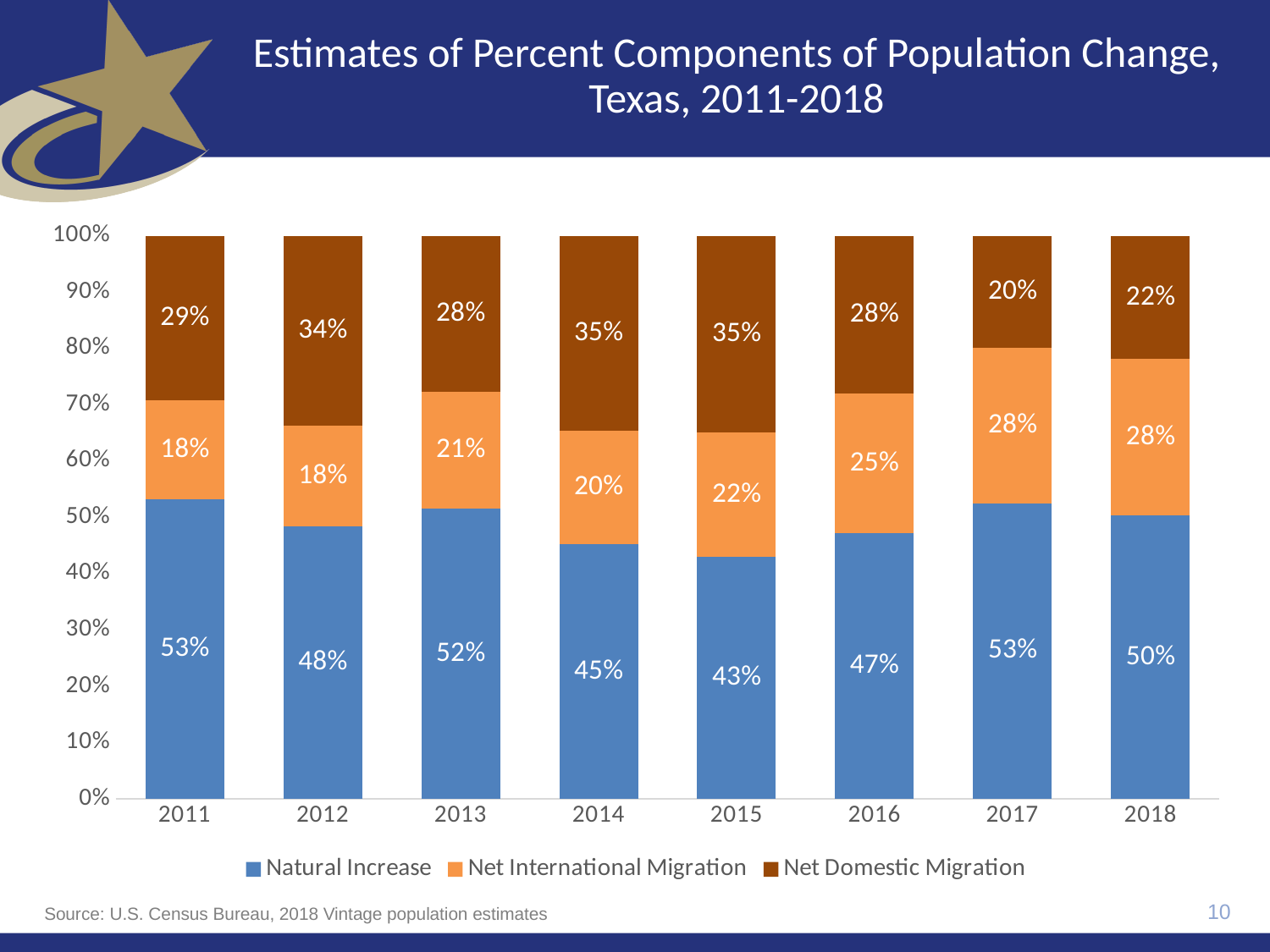
In which year was the Natural Increase share lowest? 2015 What was the Net International Migration share in 2013? 21% How many years are shown on the x axis? 8 What was the Net Domestic Migration share in 2017? 20% What is the difference between the Net Domestic Migration share in 2014 and in 2018? 13 percentage points How many series does the legend list? 3 In which year was the Net Domestic Migration share lowest? 2017 What percentage of population change in 2015 was Natural Increase? 43% Is the Natural Increase share in 2011 greater or less than 50%? greater What kind of chart is shown on the slide? Stacked bar chart Which is larger: the Natural Increase share in 2012 or in 2016? 2012 Which series is shown in dark brown in the legend? Net Domestic Migration